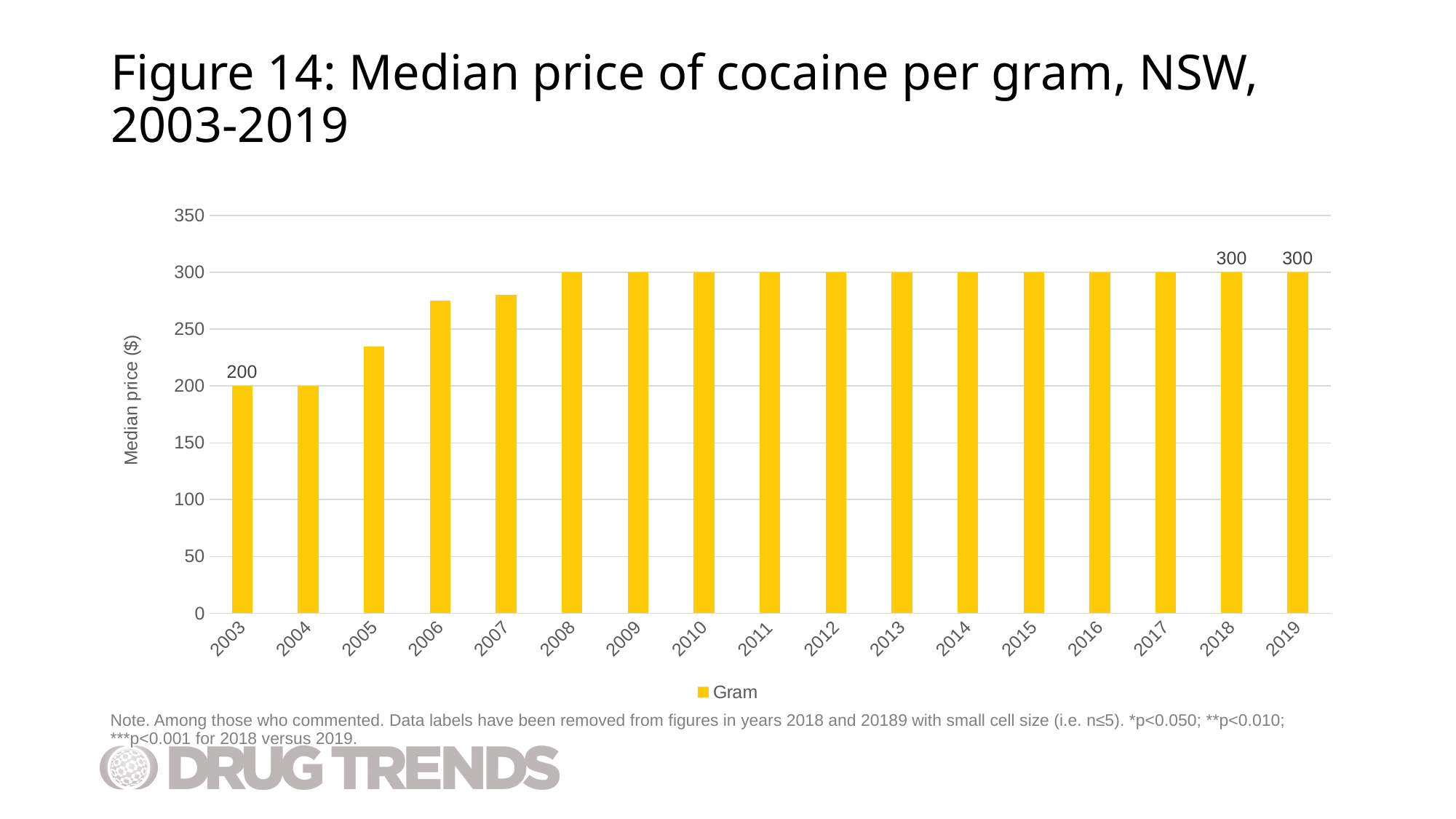
Is the median price per gram in 2006 greater or less than 250? greater Which year has the higher median price per gram, 2003 or 2018? 2018 What kind of chart is shown on the slide? bar chart What is the median price of cocaine per gram in NSW in 2004? 200 Does the median price per gram rise or fall from 2003 to 2008? rise What is the median price of cocaine per gram in NSW in 2003? 200 What is the median price of cocaine per gram in NSW in 2018? 300 Is the median price per gram in 2005 greater or less than 250? less How many years are shown on the x axis of the chart? 17 What is the median price of cocaine per gram in NSW in 2019? 300 How many series does the legend list? 1 What is the difference between the median price per gram in 2019 and in 2003? 100